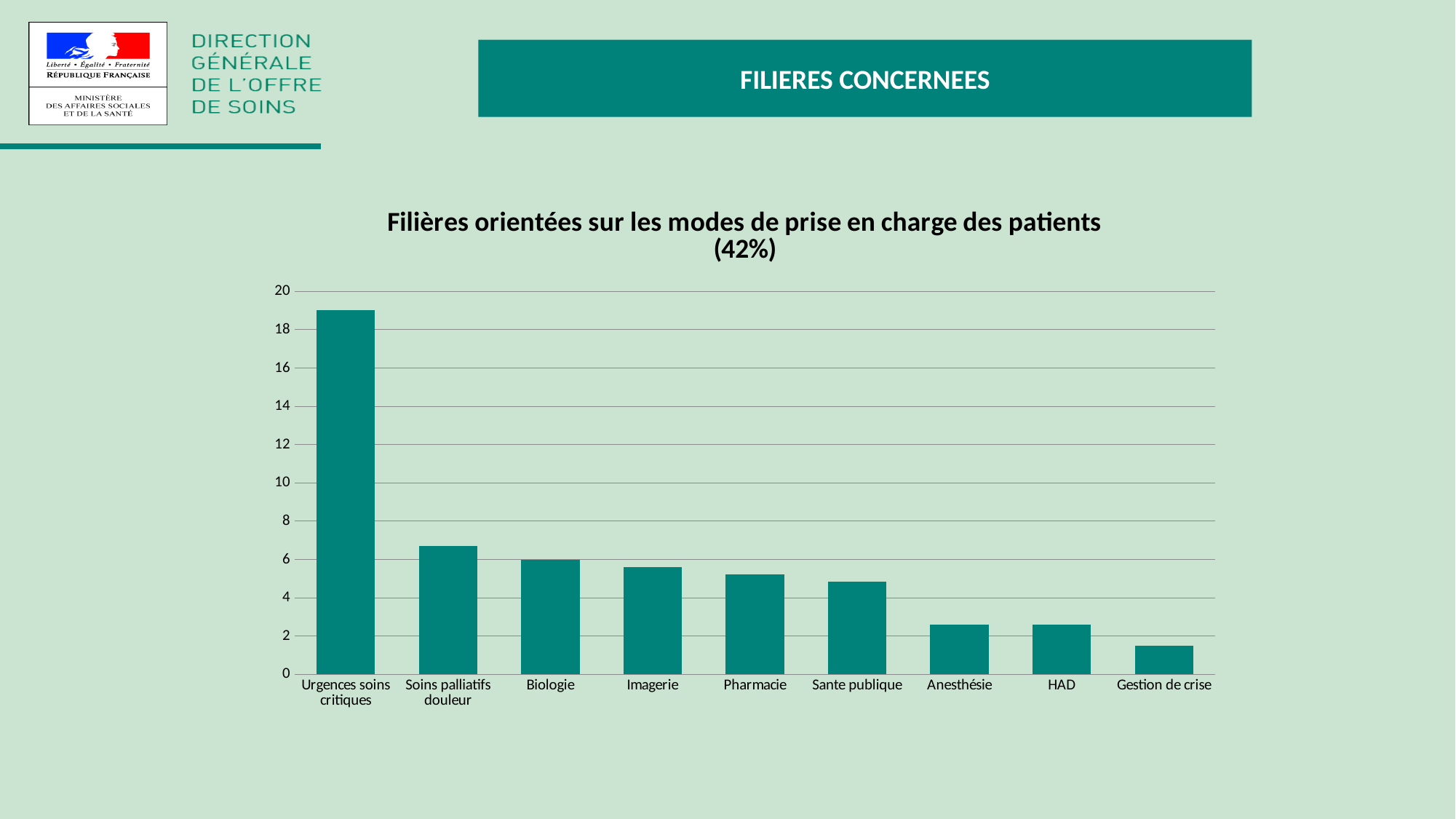
What kind of chart is shown on the slide? bar chart Do the values rise or fall from left to right along the x axis? fall Is the value for Pharmacie greater or less than 6? less What is the title of the chart? Filières orientées sur les modes de prise en charge des patients (42%) Is the value for Anesthésie greater or less than 2? greater Which category has the lowest value? Gestion de crise Is the value for Soins palliatifs douleur greater or less than 6? greater How many categories are shown on the x axis of the chart? 9 Which category has the highest value? Urgences soins critiques Which is larger, the value for Soins palliatifs douleur or the value for Pharmacie? Soins palliatifs douleur